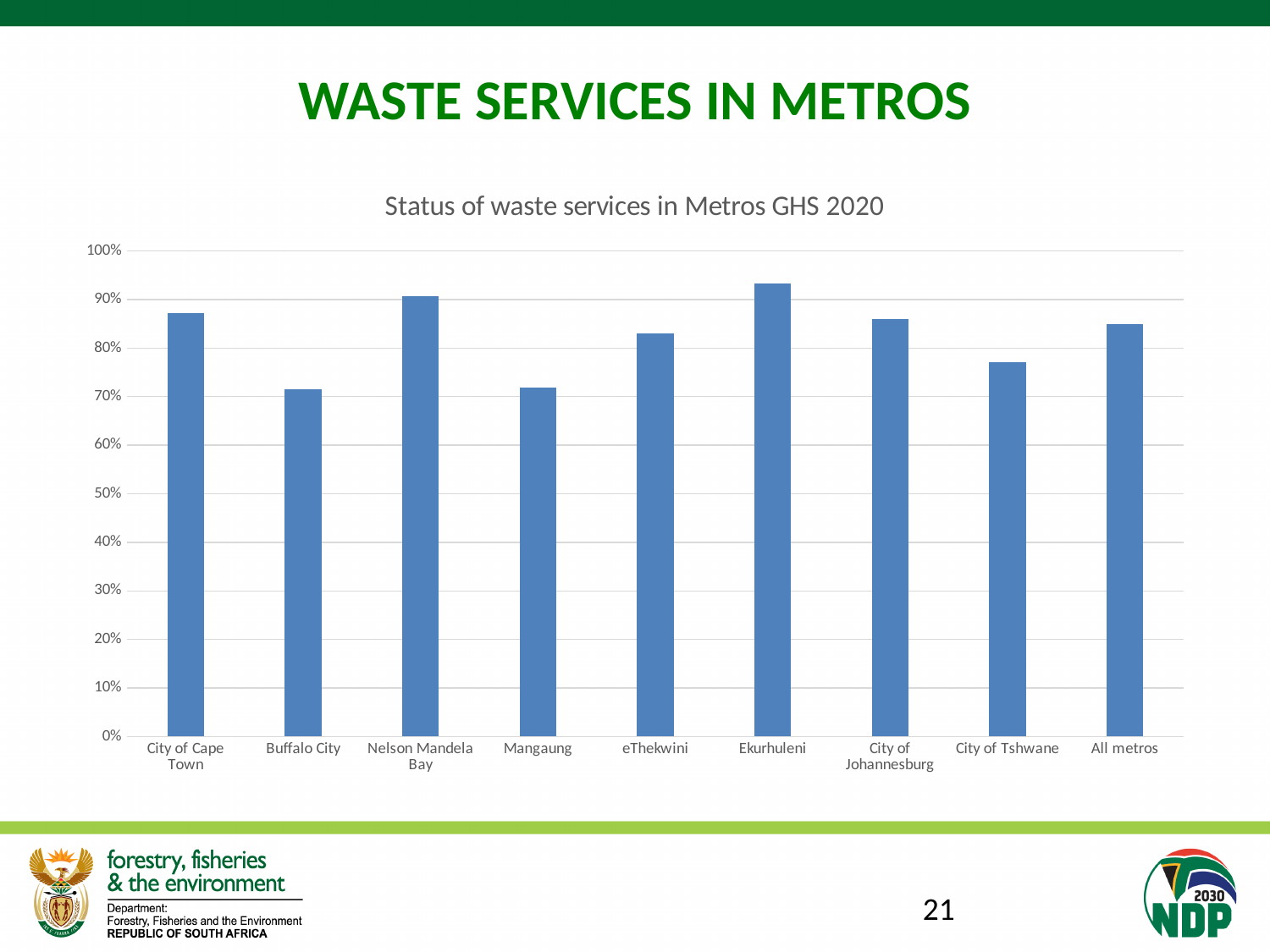
What kind of chart is shown on the slide? Bar chart Is the value for City of Tshwane greater or less than 80%? less Is the value for Ekurhuleni greater or less than 90%? greater Which is larger, the value for Nelson Mandela Bay or the value for Buffalo City? Nelson Mandela Bay How many metros/categories are plotted on the x axis? 9 Which is larger, the value for City of Cape Town or the value for City of Tshwane? City of Cape Town Is the value for All metros greater or less than 80%? greater What is the title of the chart? Status of waste services in Metros GHS 2020 Which category has the highest value? Ekurhuleni